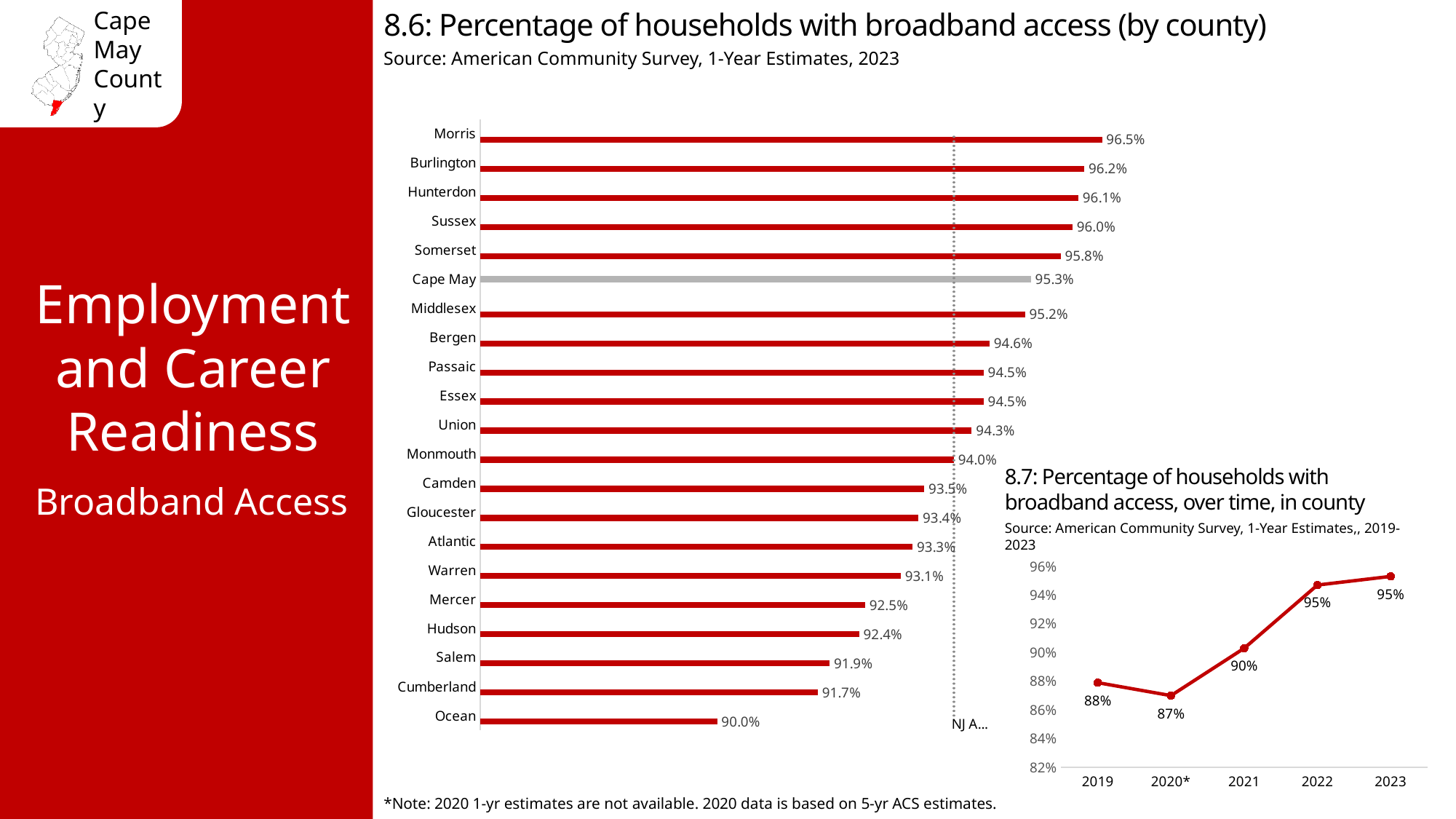
In chart 8.6, how many counties are shown? 21 In chart 8.7, how many data points are plotted? 5 In chart 8.6, what is the percentage of households with broadband access in Cape May? 95.3% In chart 8.7, what was the percentage of households with broadband access in 2021? 90% In chart 8.6, which county has the lowest percentage of households with broadband access? Ocean In chart 8.6, what is the difference between the values for Morris and Ocean? 6.5% In chart 8.6, which county has the highest percentage of households with broadband access? Morris In chart 8.6, what is the percentage of households with broadband access in Ocean? 90.0% In chart 8.7, what is the difference between the values for 2023 and 2019? 7% In chart 8.7, which year has the lowest percentage of households with broadband access? 2020* In chart 8.6, which county has a higher value, Bergen or Mercer? Bergen What kind of chart is chart 8.6? Bar chart